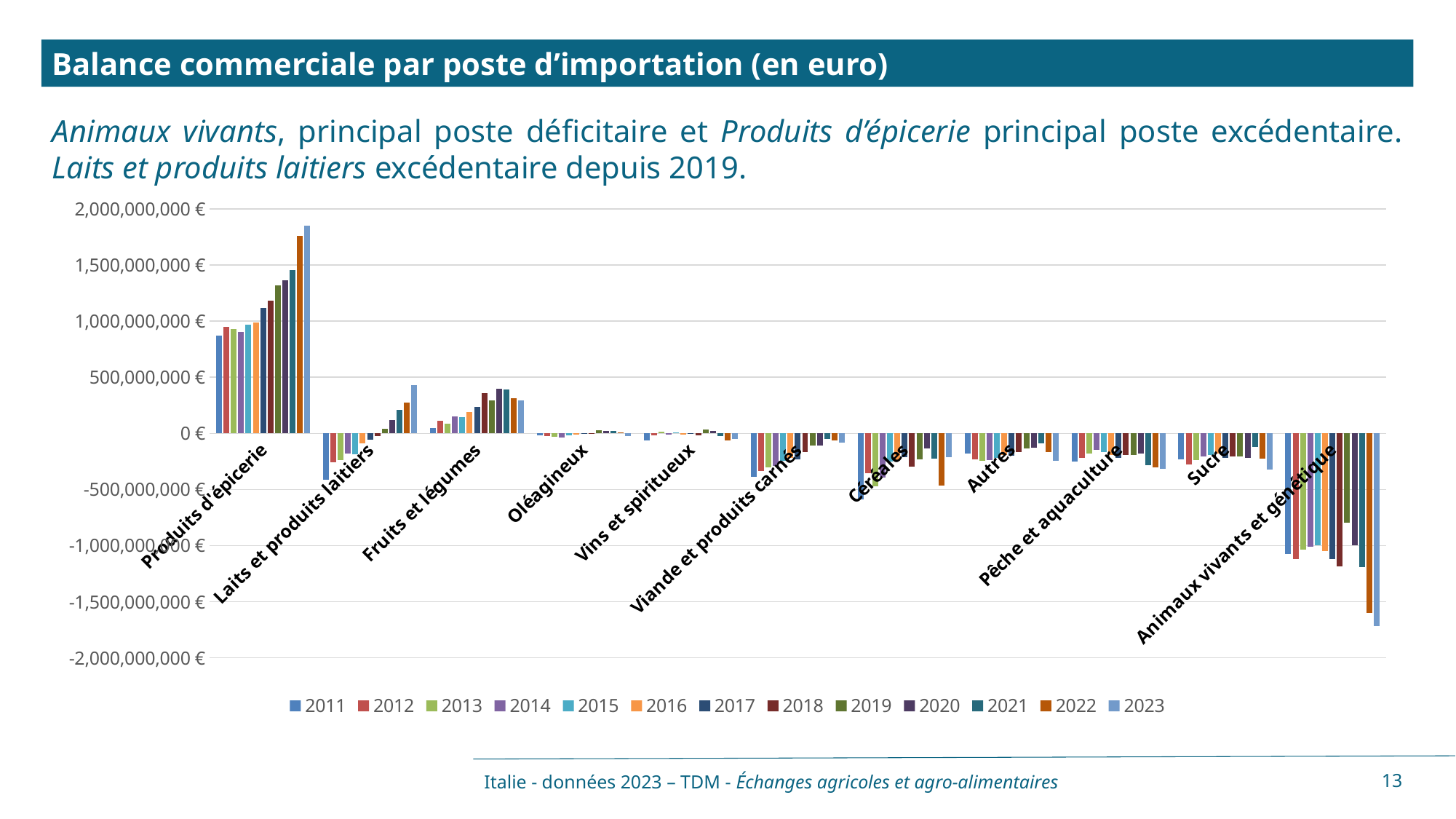
How many import categories are shown on the x axis? 11 What is the title of the chart? Balance commerciale par poste d'importation (en euro) Which category has the lowest (most negative) trade balance values? Animaux vivants et génétique Which is larger for Laits et produits laitiers: the value for 2011 or the value for 2023? 2023 Is the value for Produits d'épicerie in 2011 greater or less than 1,000,000,000 €? less Is the value for Laits et produits laitiers in 2023 greater or less than 0 €? greater What kind of chart is shown on the slide? bar chart Is the value for Animaux vivants et génétique in 2023 greater or less than -1,500,000,000 €? less Which category has the highest (most positive) trade balance values? Produits d'épicerie How many series (years) does the legend list? 13 Do the values for Produits d'épicerie rise or fall from 2011 to 2023? rise